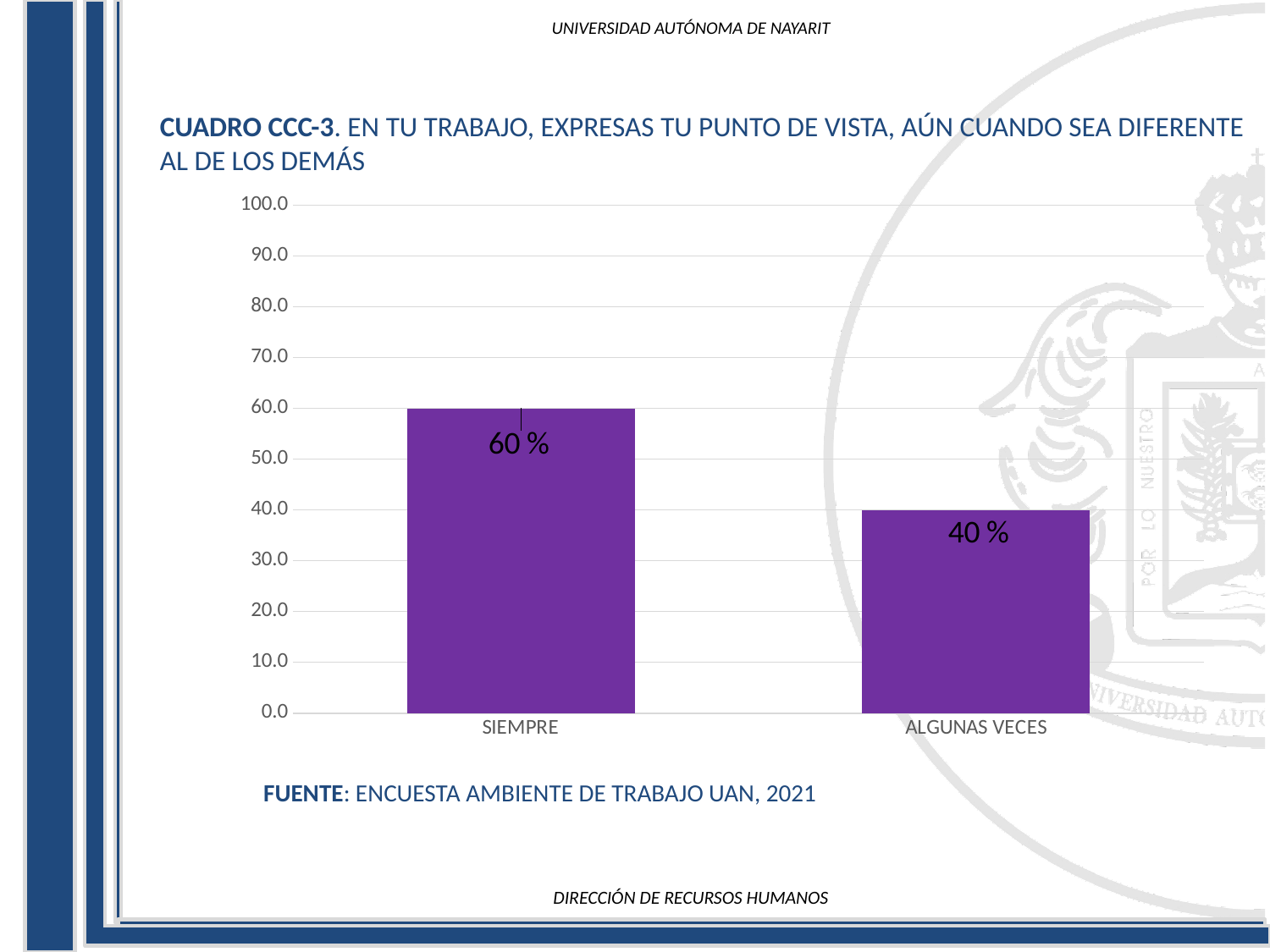
What is the difference between the values for SIEMPRE and ALGUNAS VECES? 20 % Which is larger, the value for SIEMPRE or the value for ALGUNAS VECES? SIEMPRE How many categories are shown on the x axis? 2 What is the value for ALGUNAS VECES? 40 % Which category has the lowest value? ALGUNAS VECES What kind of chart is shown on the slide? bar chart Which category has the highest value? SIEMPRE What colour are the bars in the chart? purple What is the value for SIEMPRE? 60 % Is the value for ALGUNAS VECES greater or less than 50.0? less What is the source cited below the chart? ENCUESTA AMBIENTE DE TRABAJO UAN, 2021 Is the value for SIEMPRE greater or less than 50.0? greater